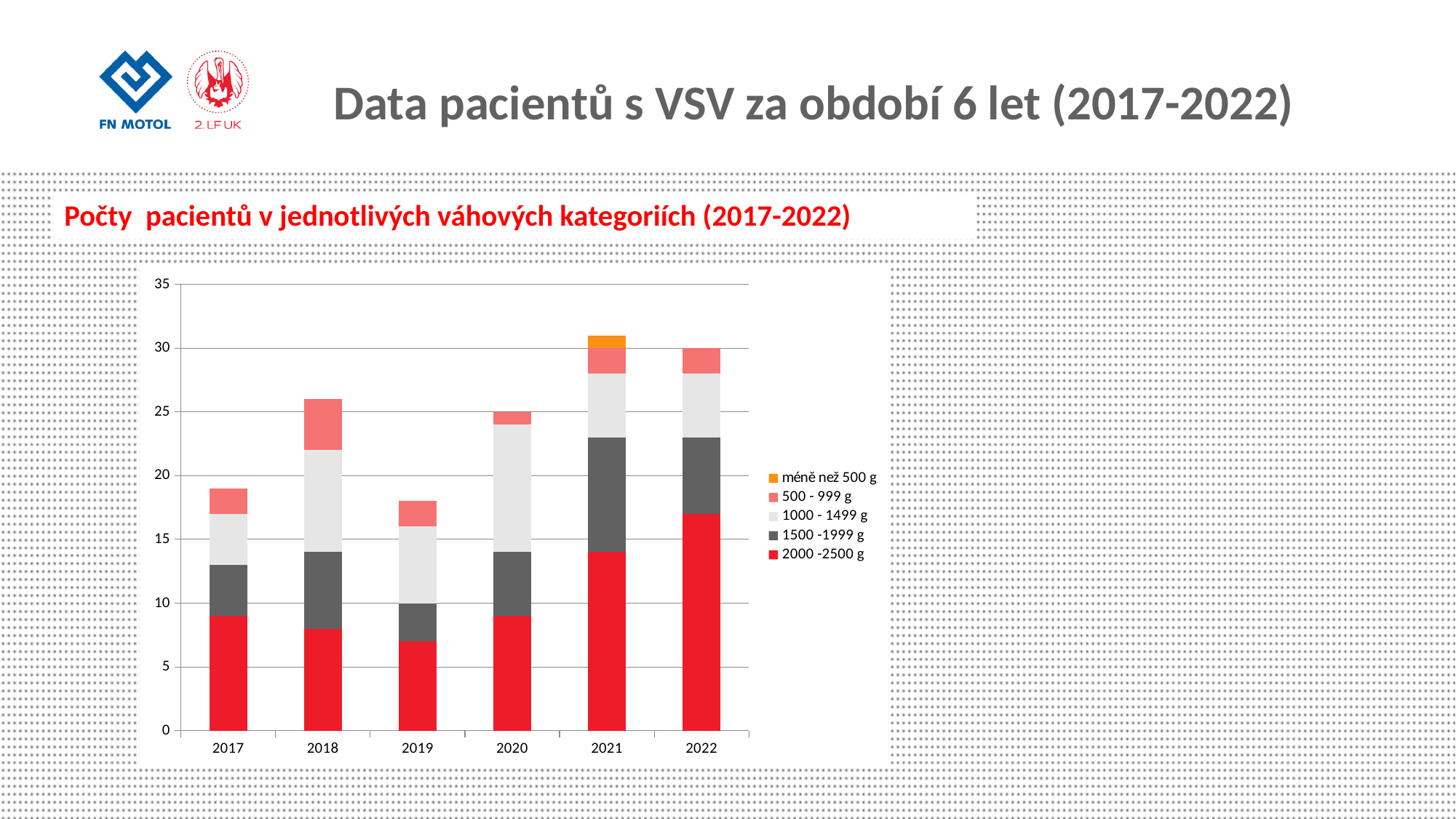
Is the total height of the bar for 2021 greater or less than 30? greater What is the title shown above the chart? Počty pacientů v jednotlivých váhových kategoriích (2017-2022) Is the 2000 -2500 g segment for 2022 greater or less than 15? greater Is the total height of the bar for 2019 greater or less than 20? less How many weight categories does the legend list? 5 Which bar is taller in total, 2018 or 2019? 2018 How many years are shown on the x axis of the chart? 6 Which year has the larger 2000 -2500 g segment, 2017 or 2022? 2022 Which year is the only one with a 'méně než 500 g' segment? 2021 What kind of chart is shown on the slide? stacked bar chart